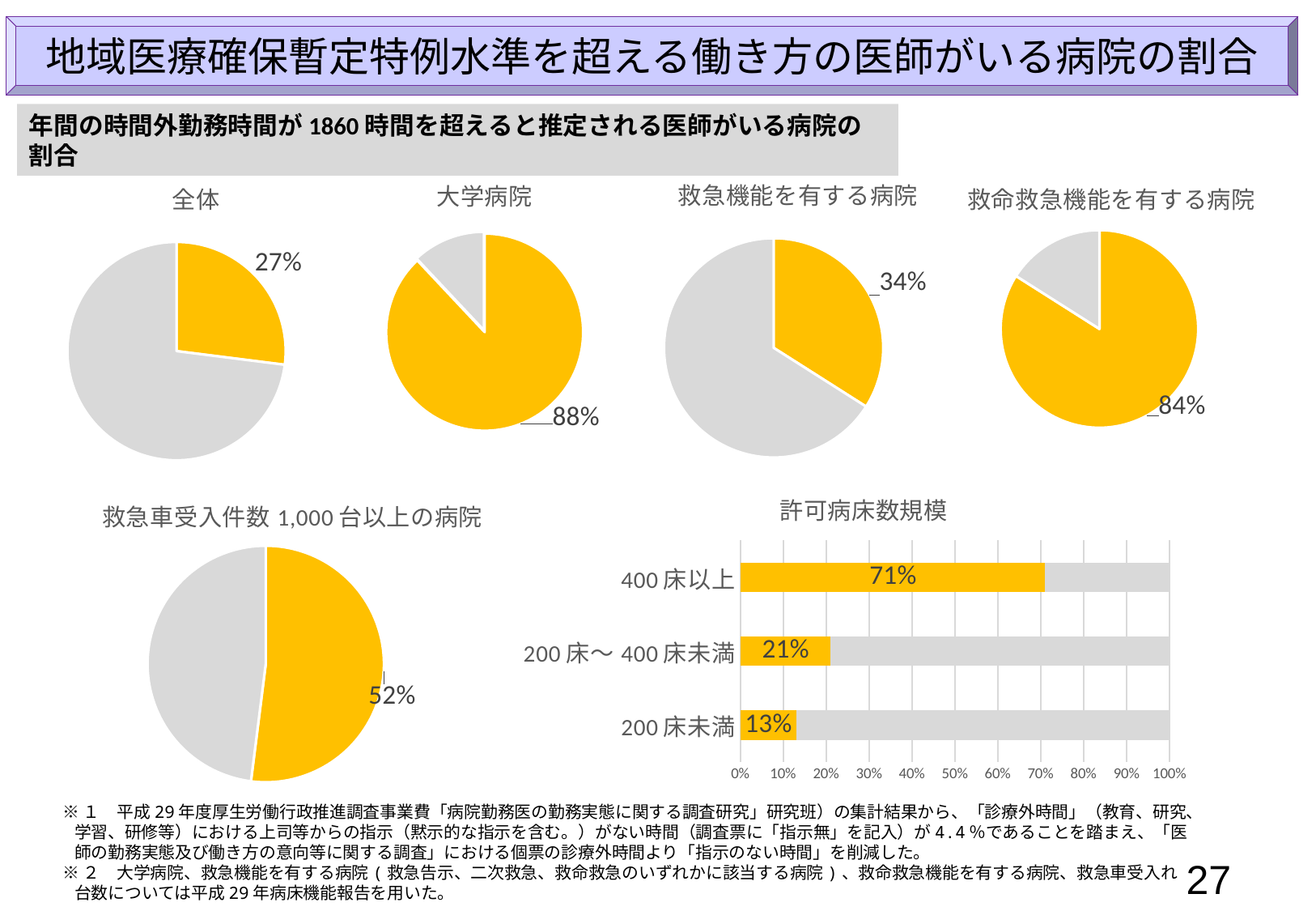
In the bar chart titled 許可病床数規模, what is the difference between the values for 400 床以上 and 200 床〜400 床未満? 50% Which of the pie charts, 大学病院 or 救急機能を有する病院, shows the larger labelled percentage? 大学病院 In the pie chart titled 救急車受入件数 1,000 台以上の病院, what percentage is labelled? 52% In the pie chart titled 全体, what percentage is shown for the yellow slice? 27% In the bar chart titled 許可病床数規模, what is the value for 200 床未満? 13% In the pie chart titled 救命救急機能を有する病院, what percentage is labelled? 84% In the bar chart titled 許可病床数規模, how many categories are shown? 3 In the pie chart titled 大学病院, what percentage is shown for the yellow slice? 88% In the bar chart titled 許可病床数規模, which category has the highest value? 400 床以上 What kind of chart is the chart titled 許可病床数規模? bar chart In the pie chart titled 救急機能を有する病院, what percentage is labelled? 34% In the bar chart titled 許可病床数規模, what is the value for 400 床以上? 71%